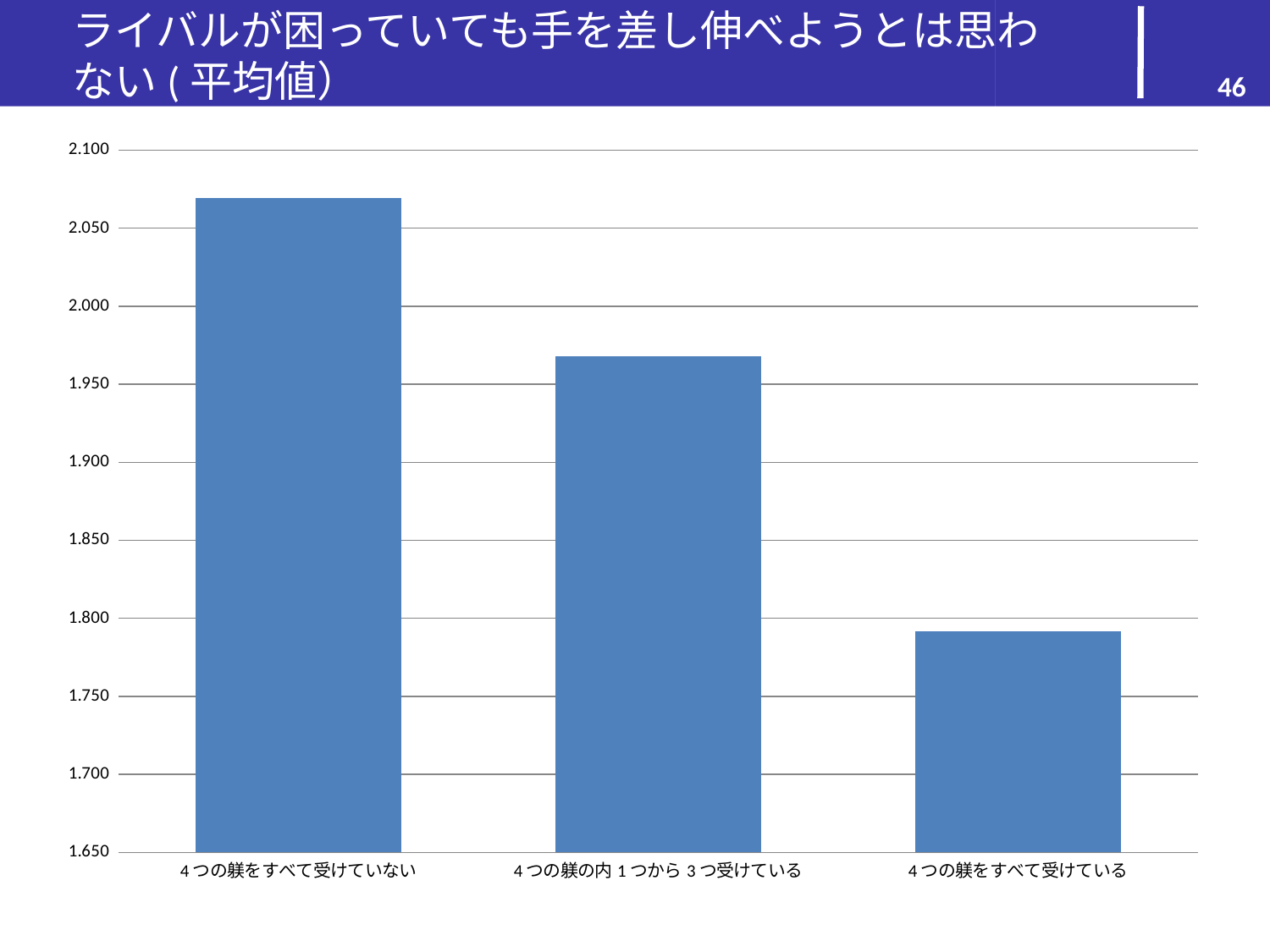
How many categories are plotted on the x axis? 3 Is the value for 4つの躾をすべて受けていない greater or less than 2.050? greater Is the value for 4つの躾の内1つから3つ受けている greater or less than 2.000? less Which category has the highest value? 4つの躾をすべて受けていない Is the value for 4つの躾をすべて受けている greater or less than 1.800? less Which is larger, the value for 4つの躾の内1つから3つ受けている or the value for 4つの躾をすべて受けている? 4つの躾の内1つから3つ受けている What kind of chart is shown on the slide? bar chart Which is larger, the value for 4つの躾をすべて受けていない or the value for 4つの躾の内1つから3つ受けている? 4つの躾をすべて受けていない Do the values rise or fall from left to right along the x axis? fall Which category has the lowest value? 4つの躾をすべて受けている What is the title of the slide containing the chart? ライバルが困っていても手を差し伸べようとは思わない(平均値)